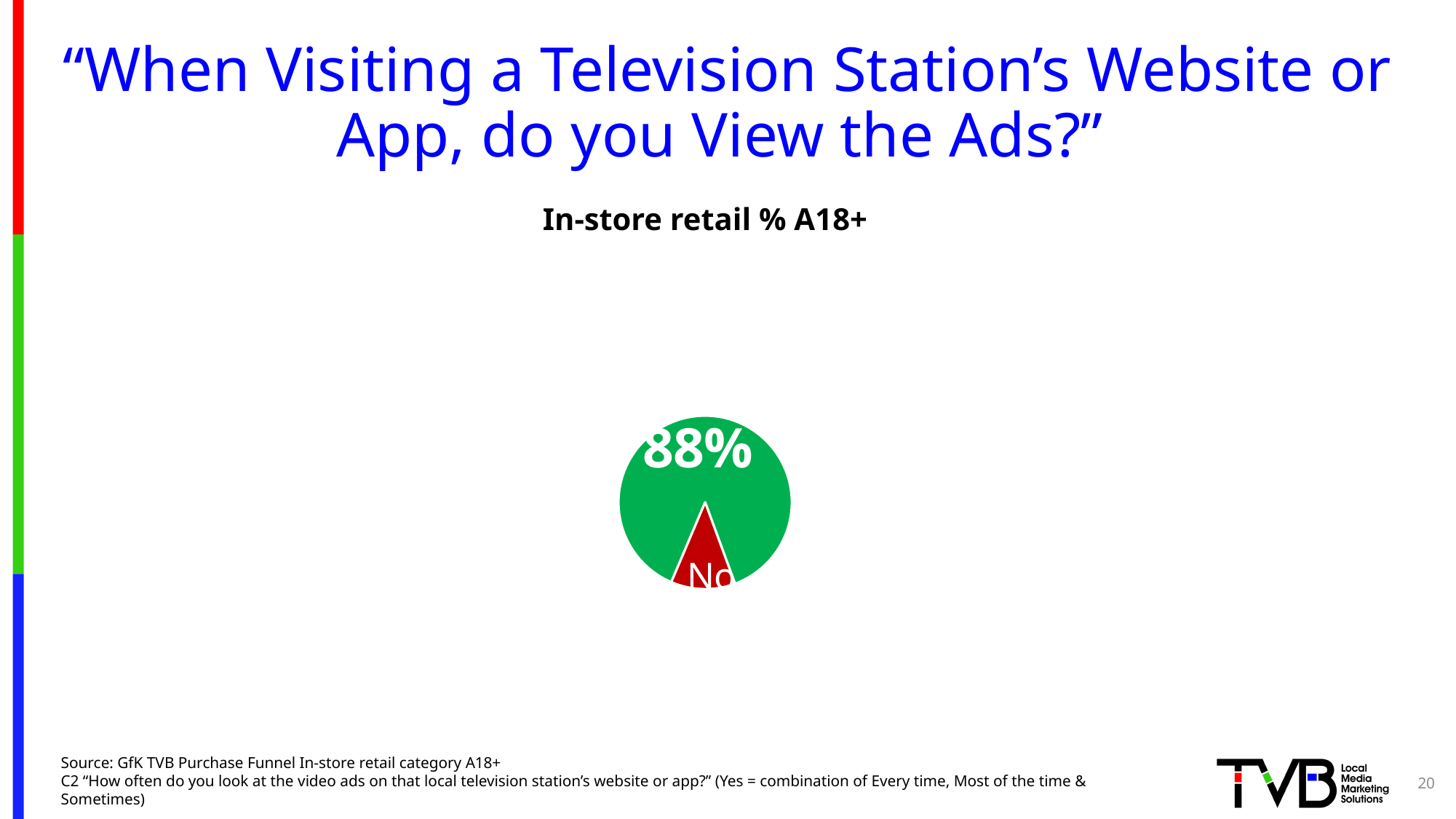
Which slice of the pie chart is the smallest? No What colour is the "No" slice of the pie chart? red What kind of chart is shown on the slide? pie chart Is the "No" slice larger or smaller than the slice labelled 88%? smaller How many slices does the pie chart have? 2 What percentage is printed on the large green slice of the pie chart? 88% What is the title printed above the pie chart? In-store retail % A18+